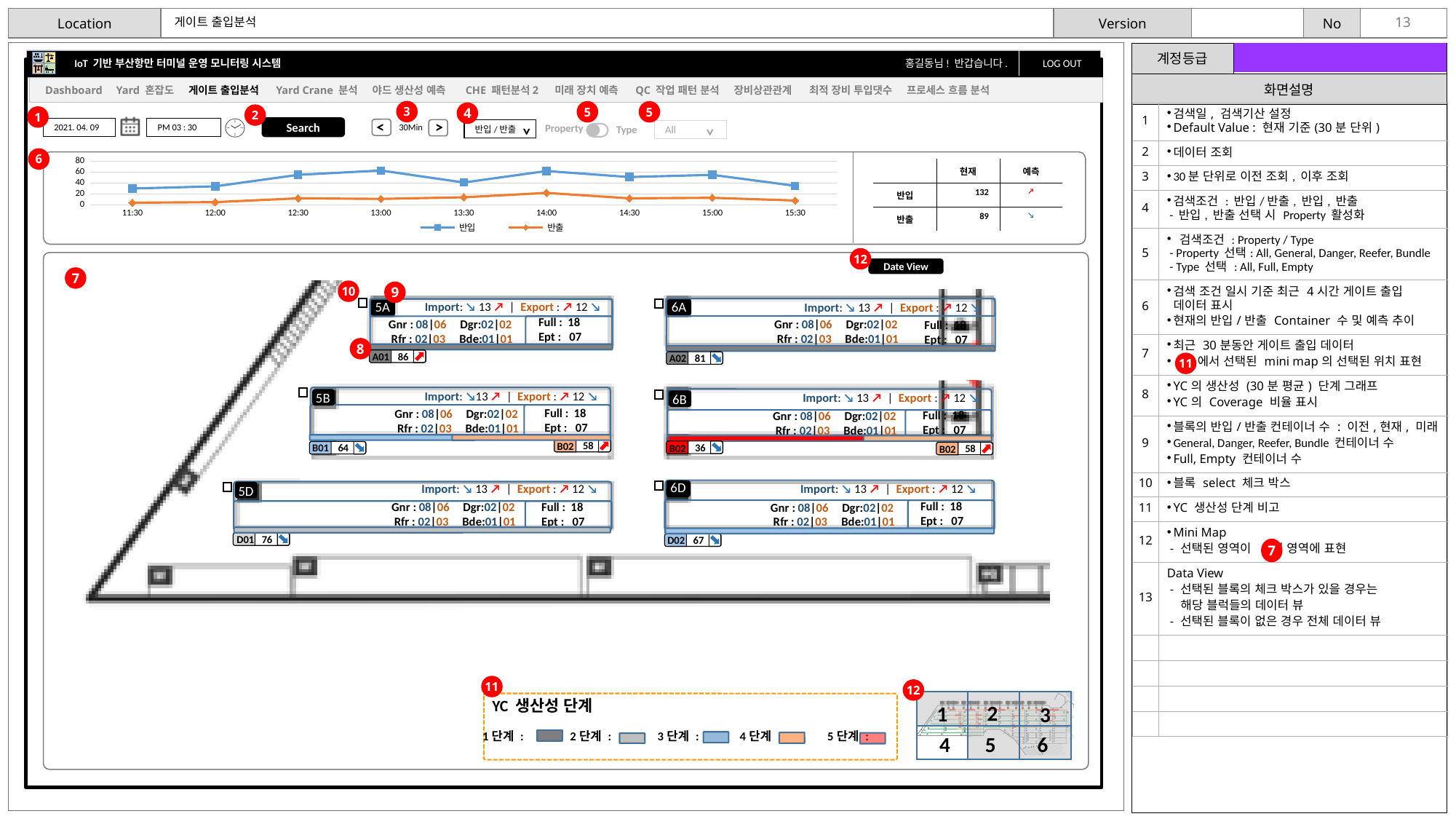
In the line chart, is the 반출 value at 14:00 greater or less than 40? less In the line chart, is the 반출 value at 11:30 greater or less than 20? less In the line chart, is the 반입 value at 13:00 greater or less than 40? greater What kind of chart is shown in the top panel of the dashboard (item 6)? line chart In the line chart, which series has the larger value at 13:00, 반입 or 반출? 반입 In the line chart, does the 반입 series rise or fall from 12:00 to 13:00? rise Which colour is used for the 반입 series in the line chart? blue How many series does the legend of the line chart list? 2 What are the two legend entries of the line chart? 반입, 반출 How many time points are plotted along the x axis of the line chart? 9 In the line chart, at which time is the 반출 series highest? 14:00